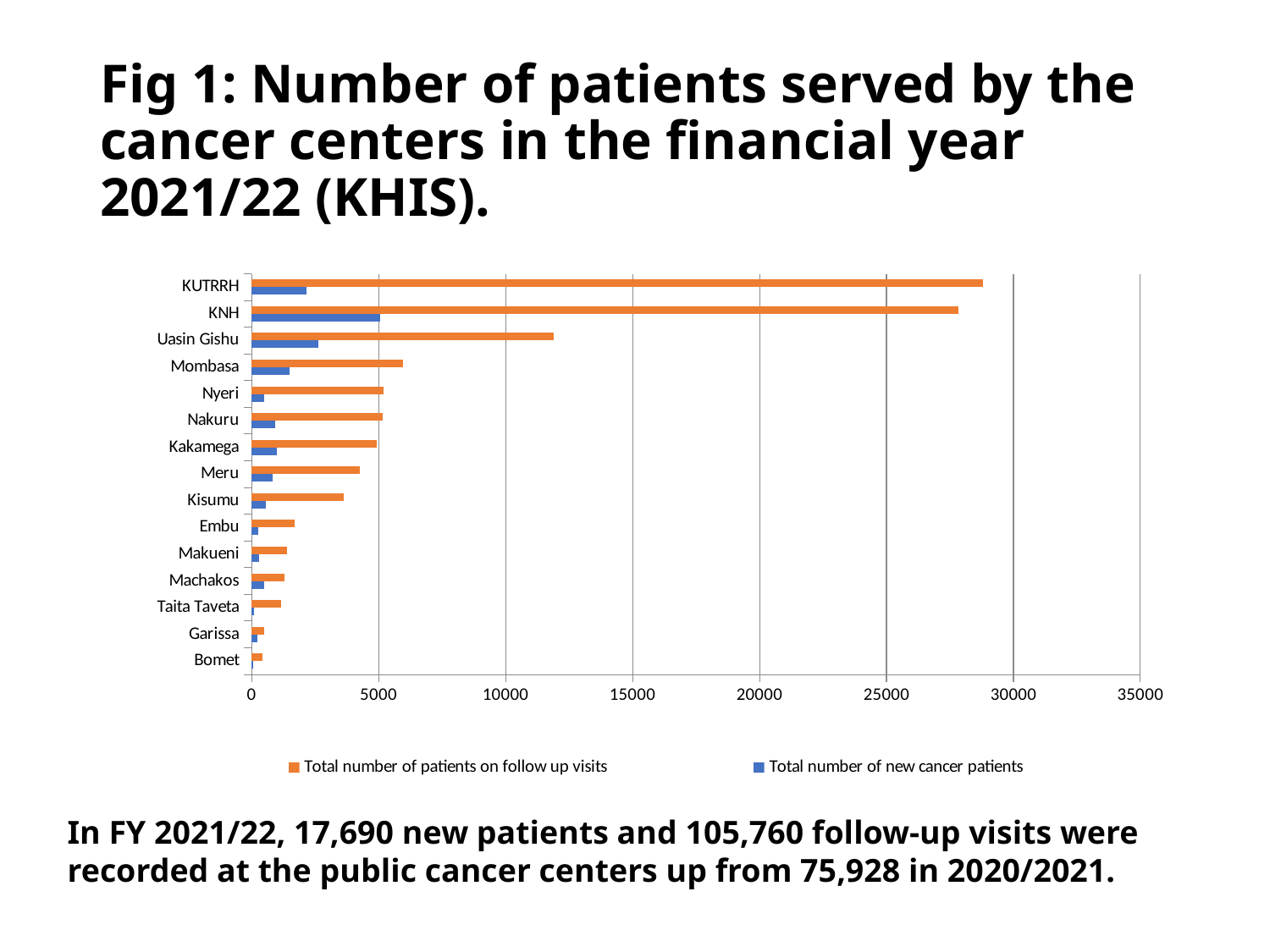
How many cancer centers are listed on the chart? 15 Is the total number of patients on follow up visits for Kisumu greater or less than 5000? less Is the total number of patients on follow up visits for KUTRRH greater or less than 25000? greater Which has more new cancer patients, Mombasa or Nyeri? Mombasa Which cancer center has the highest total number of patients on follow up visits? KUTRRH Which colour represents the total number of patients on follow up visits? orange What kind of chart is shown on the slide? bar chart Is the total number of new cancer patients for Uasin Gishu greater or less than 5000? less How many series does the legend list? 2 Which cancer center has the highest total number of new cancer patients? KNH Which has more patients on follow up visits, Uasin Gishu or Mombasa? Uasin Gishu